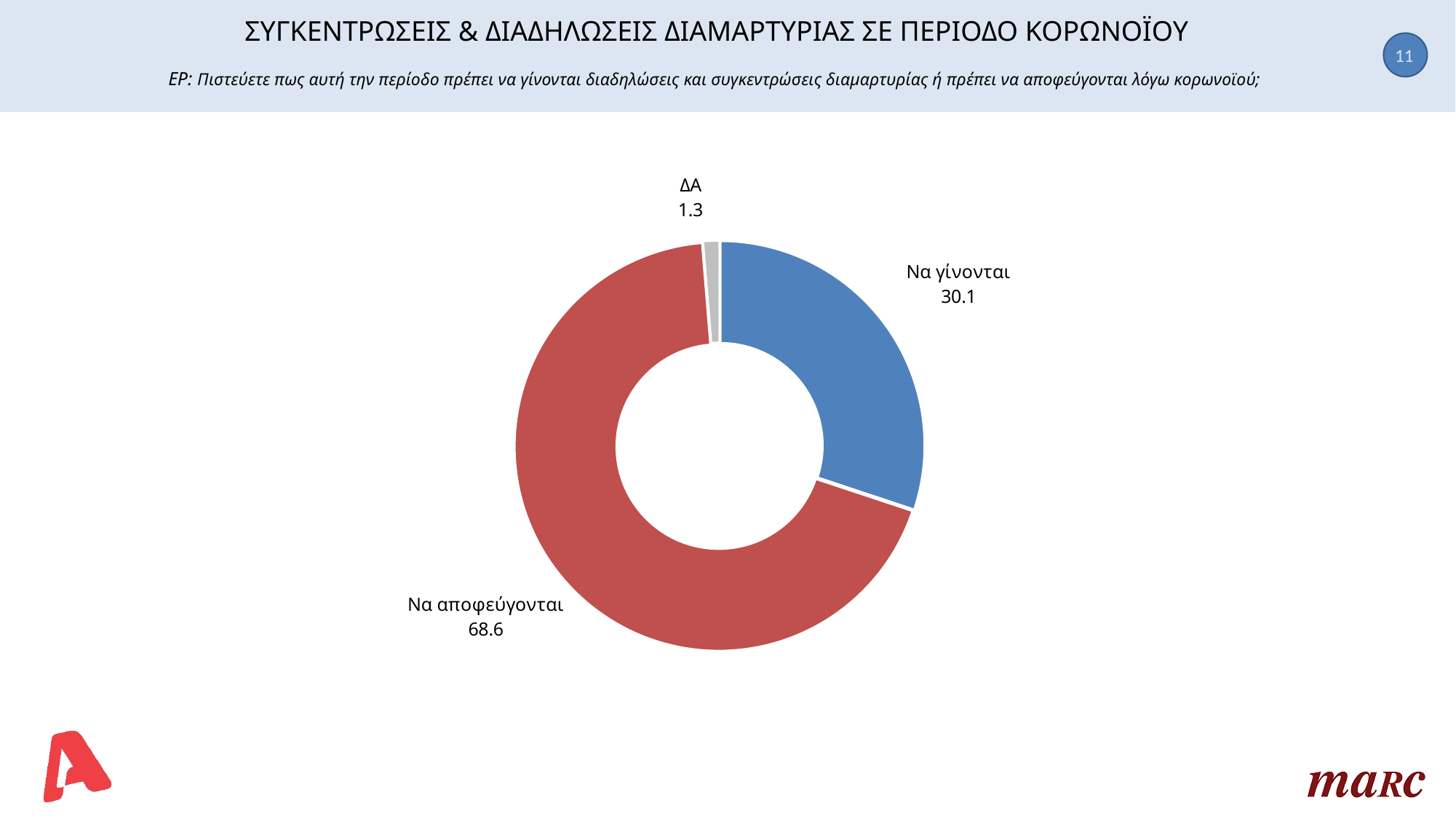
What is the total of the three values shown in the chart? 100 What colour is the "Να γίνονται" slice? Blue What is the value for "ΔΑ"? 1.3 What kind of chart is shown on the slide? Doughnut chart Which is larger, the value for "Να γίνονται" or the value for "ΔΑ"? Να γίνονται How many categories are shown in the chart? 3 What is the value for "Να αποφεύγονται"? 68.6 What is the value for "Να γίνονται"? 30.1 What colour is the "Να αποφεύγονται" slice? Red Which category has the highest value? Να αποφεύγονται What is the difference between the values for "Να αποφεύγονται" and "Να γίνονται"? 38.5 Which category has the lowest value? ΔΑ